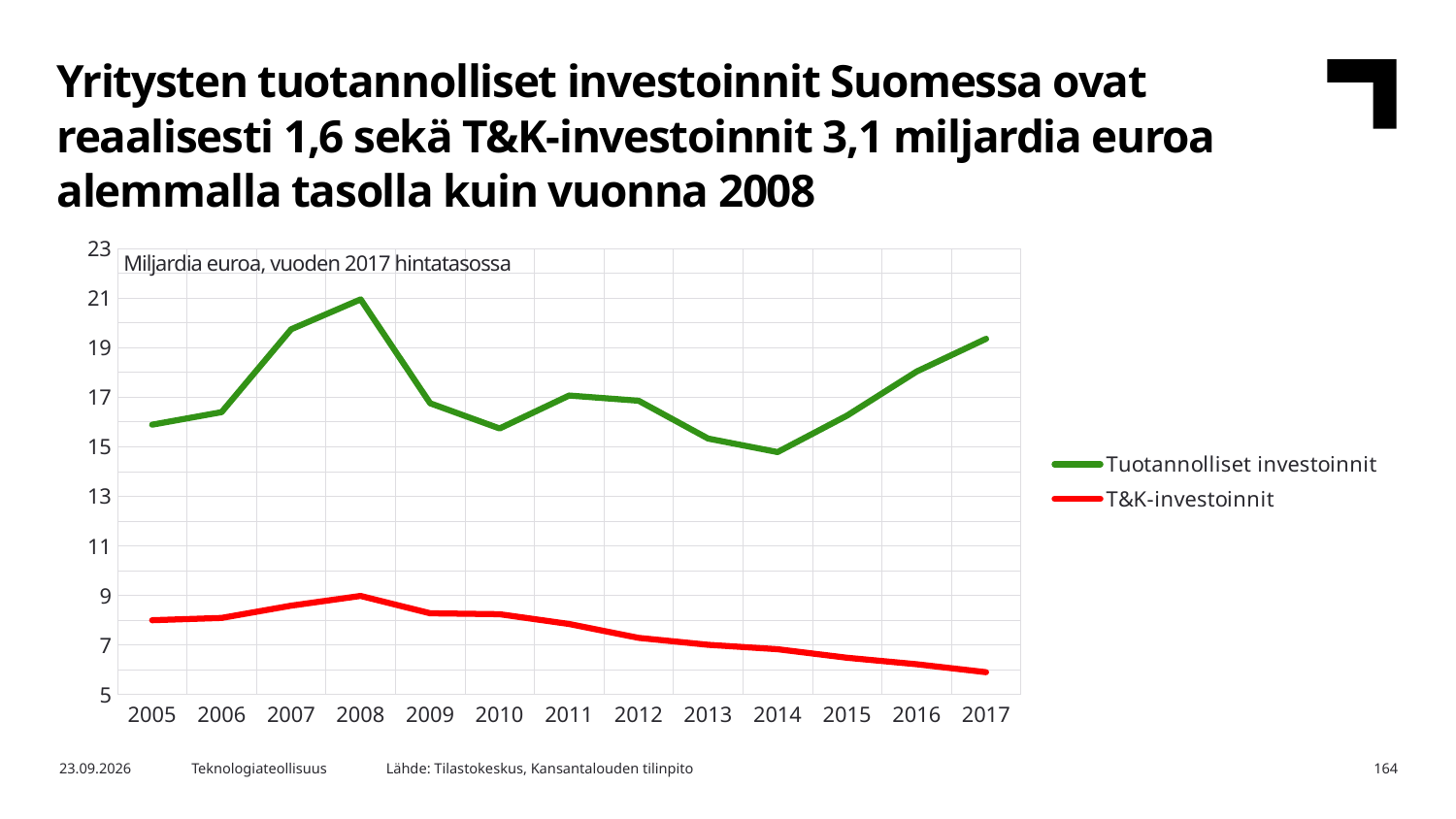
In which year is the value for T&K-investoinnit lowest? 2017 How many series does the legend list? 2 Do the values for T&K-investoinnit rise or fall from 2008 to 2017? fall Is the value for Tuotannolliset investoinnit in 2005 greater or less than 17? less In which year is the value for Tuotannolliset investoinnit lowest? 2014 Is the value for Tuotannolliset investoinnit in 2008 greater or less than 19? greater What kind of chart is shown on the slide? line chart Which series has the larger value in 2017, Tuotannolliset investoinnit or T&K-investoinnit? Tuotannolliset investoinnit How many years are shown on the x axis? 13 In which year is the value for T&K-investoinnit highest? 2008 Is the value for T&K-investoinnit in 2017 greater or less than 7? less In which year is the value for Tuotannolliset investoinnit highest? 2008